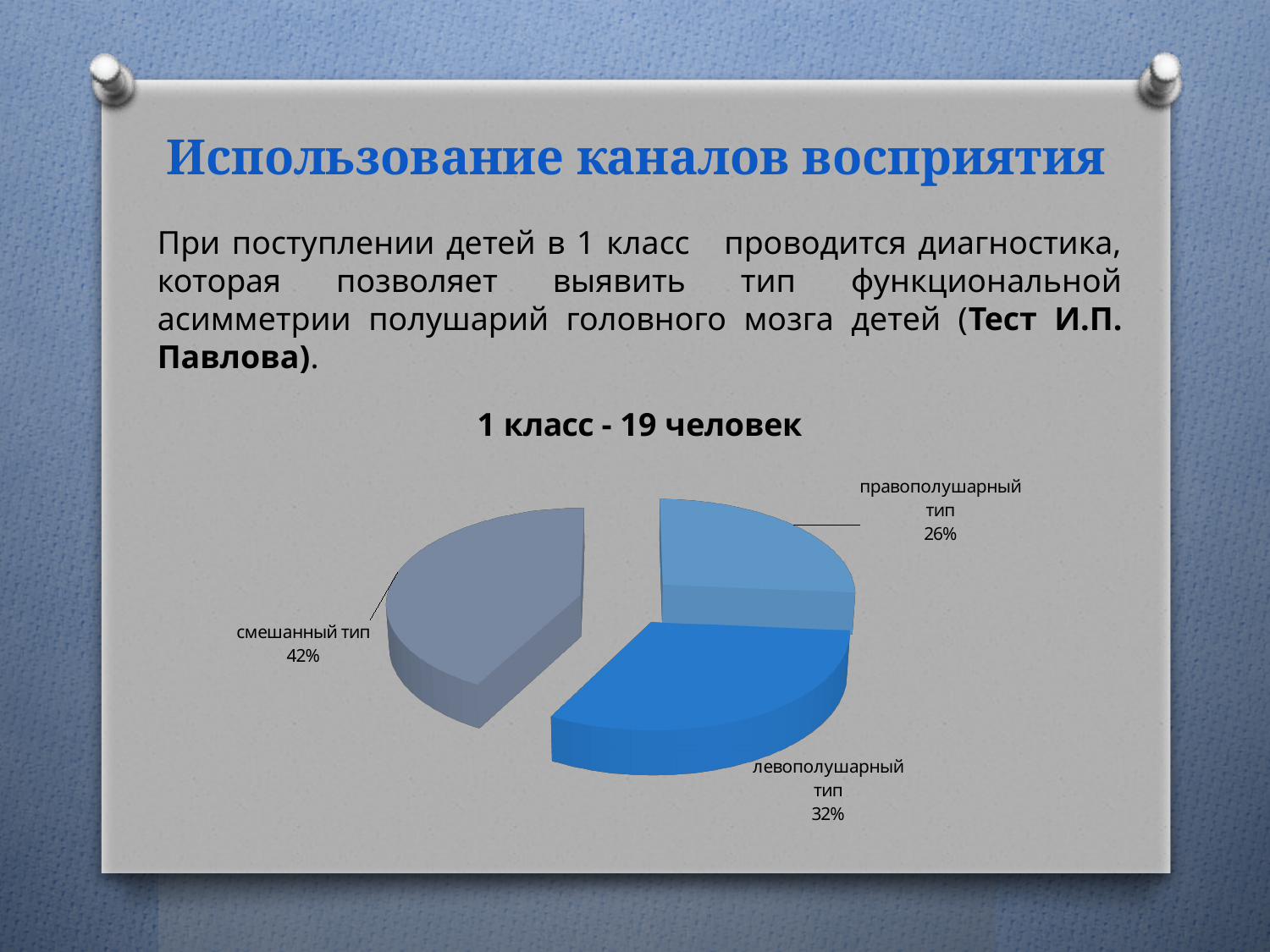
What is the difference in percentage points between левополушарный тип and правополушарный тип? 6 What is the title of the chart? 1 класс - 19 человек What share of the pie does смешанный тип have? 42% What share of the pie does правополушарный тип have? 26% Which category has the smallest share of the pie? правополушарный тип How many slices does the pie chart have? 3 Is the share for смешанный тип greater or less than 40%? greater Which is larger: the share for левополушарный тип or the share for правополушарный тип? левополушарный тип What share of the pie does левополушарный тип have? 32% Which category has the largest share of the pie? смешанный тип What is the difference in percentage points between смешанный тип and правополушарный тип? 16 What kind of chart is shown on the slide? pie chart